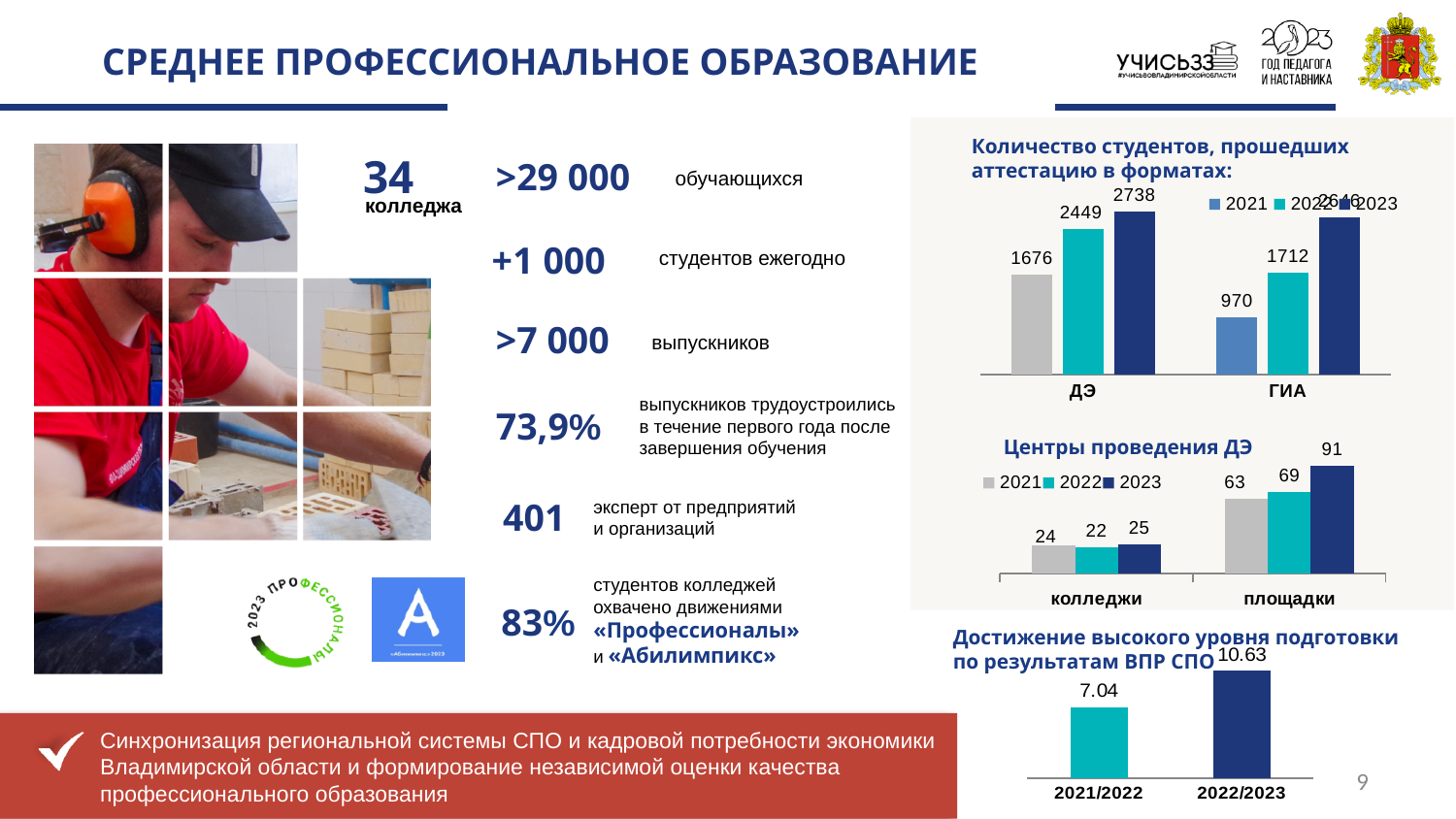
In the chart 'Количество студентов, прошедших аттестацию в форматах', do the ДЭ values rise or fall from 2021 to 2023? rise In the chart 'Количество студентов, прошедших аттестацию в форматах', what is the value for ГИА in 2021? 970 In the chart 'Количество студентов, прошедших аттестацию в форматах', how many series does the legend list? 3 In the chart 'Достижение высокого уровня подготовки по результатам ВПР СПО', what is the value for 2022/2023? 10.63 In the chart 'Центры проведения ДЭ', which year has the lowest value for колледжи? 2022 In the chart 'Центры проведения ДЭ', what is the value for площадки in 2023? 91 What kind of chart is 'Достижение высокого уровня подготовки по результатам ВПР СПО'? bar chart In the chart 'Центры проведения ДЭ', what is the difference between the площадки values for 2023 and 2022? 22 In the chart 'Количество студентов, прошедших аттестацию в форматах', what is the value for ДЭ in 2022? 2449 In the chart 'Центры проведения ДЭ', how many categories are shown on the x axis? 2 In the chart 'Достижение высокого уровня подготовки по результатам ВПР СПО', which period has the higher value, 2021/2022 or 2022/2023? 2022/2023 In the chart 'Количество студентов, прошедших аттестацию в форматах', what is the difference between the ДЭ values for 2023 and 2021? 1062